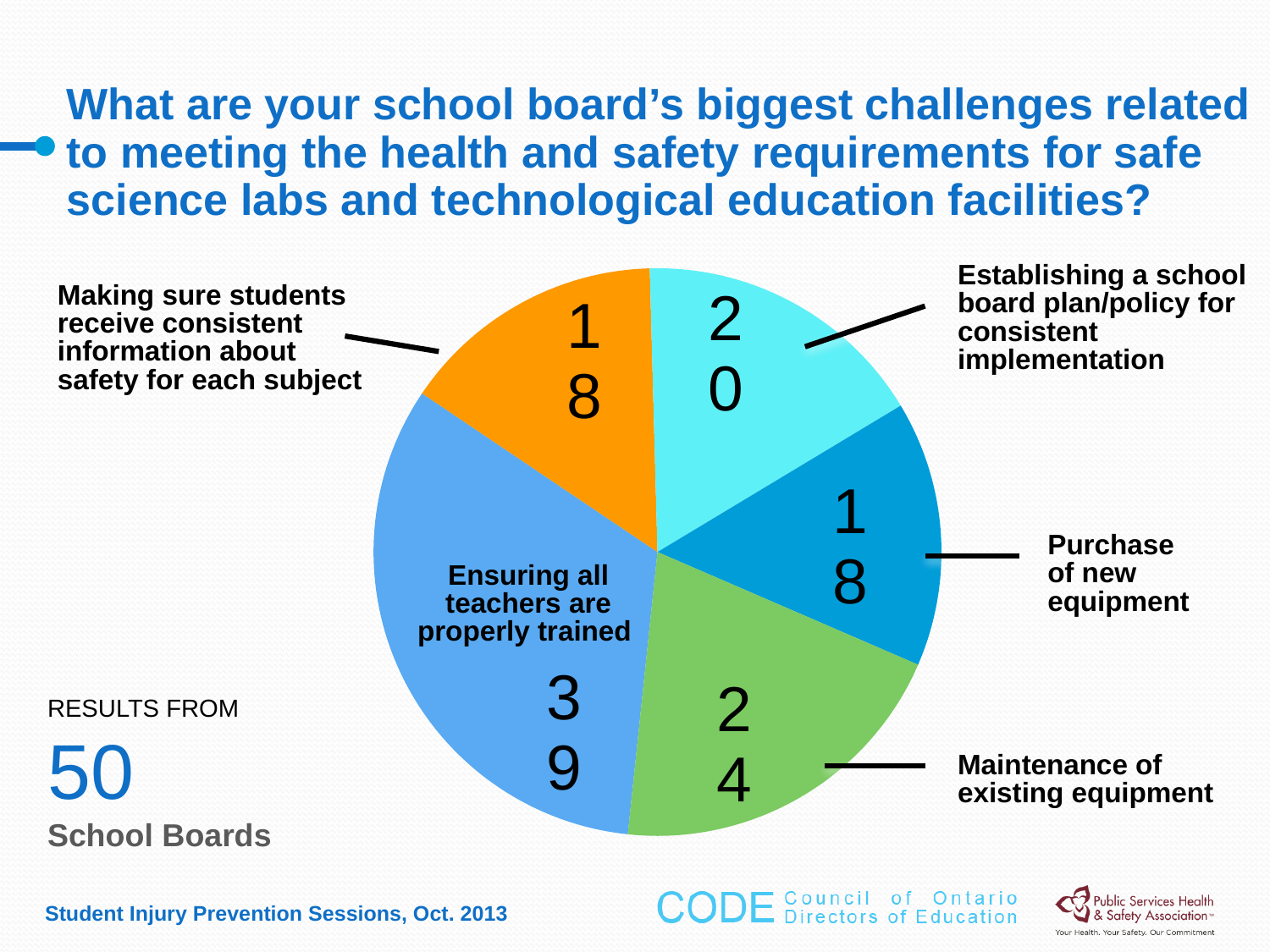
What is the difference between the values for 'Maintenance of existing equipment' and 'Purchase of new equipment'? 6 Which challenge has the largest slice of the pie chart? Ensuring all teachers are properly trained What is the value for 'Ensuring all teachers are properly trained'? 39 How many slices does the pie chart have? 5 What is the value for 'Making sure students receive consistent information about safety for each subject'? 18 What kind of chart is shown on the slide? pie chart What is the difference between the values for 'Ensuring all teachers are properly trained' and 'Maintenance of existing equipment'? 15 What colour is the slice for 'Ensuring all teachers are properly trained'? blue What is the value for 'Maintenance of existing equipment'? 24 What is the value for 'Purchase of new equipment'? 18 What is the value for 'Establishing a school board plan/policy for consistent implementation'? 20 Which is larger: 'Maintenance of existing equipment' or 'Establishing a school board plan/policy for consistent implementation'? Maintenance of existing equipment